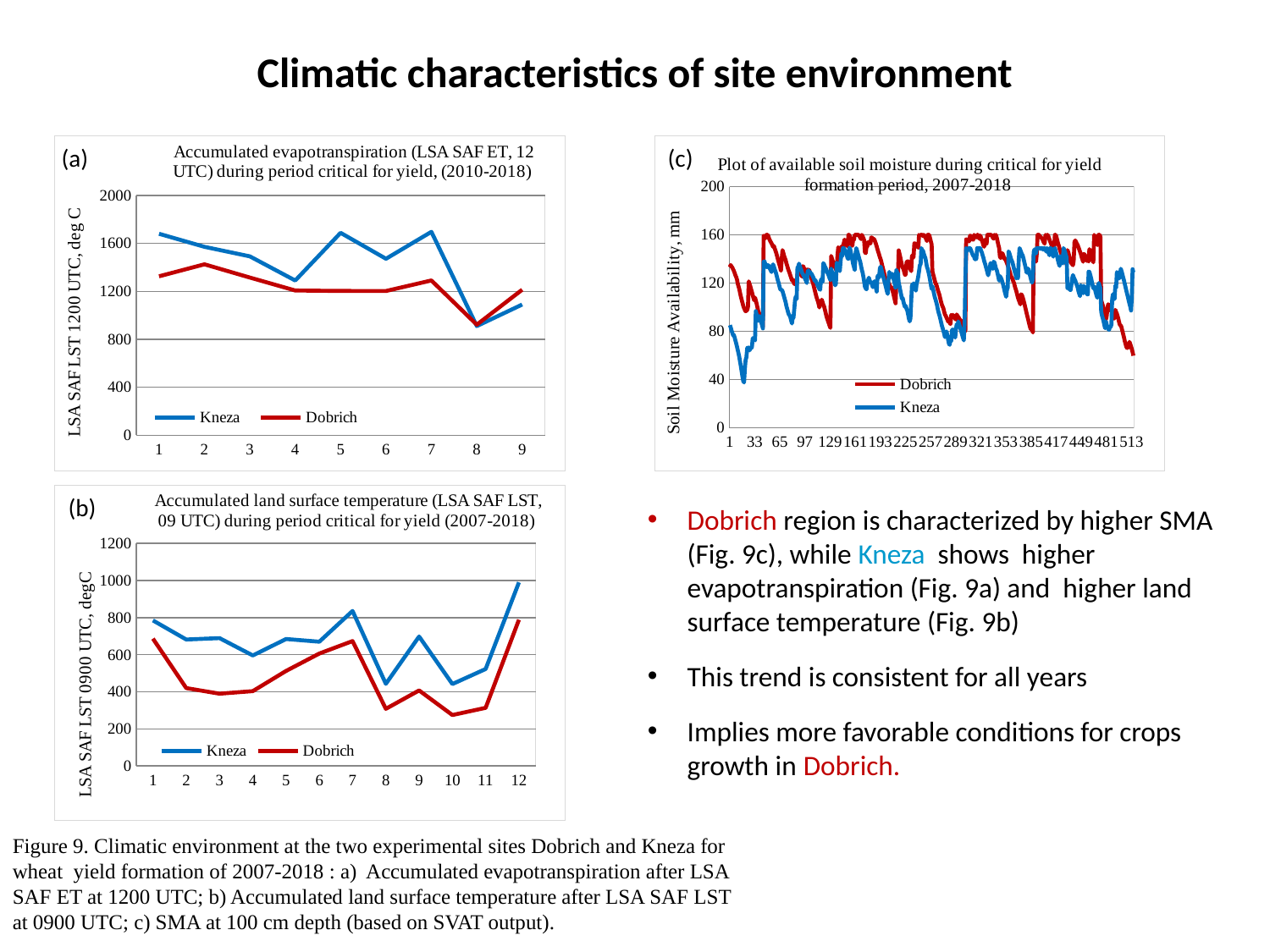
What kind of chart is chart (b), accumulated land surface temperature? line chart In chart (b), accumulated land surface temperature, how many points are plotted along the x axis for each series? 12 In chart (a), accumulated evapotranspiration, how many series does the legend list? 2 In chart (b), accumulated land surface temperature, at which x value is the Kneza series highest? 12 In chart (a), accumulated evapotranspiration, is the Kneza value at x = 9 greater or less than 1200? less In chart (b), accumulated land surface temperature, is the Dobrich value at x = 8 greater or less than 400? less In chart (a), accumulated evapotranspiration, is the Kneza value at x = 1 greater or less than 1600? greater In chart (a), accumulated evapotranspiration, how many points are plotted along the x axis for each series? 9 In chart (a), accumulated evapotranspiration, at which x value is the Dobrich series highest? 2 In chart (a), accumulated evapotranspiration, at which x value is the Kneza series lowest? 8 In chart (c), soil moisture availability, which two series does the legend list? Dobrich and Kneza In chart (a), accumulated evapotranspiration, which series has the higher value at x = 1, Kneza or Dobrich? Kneza